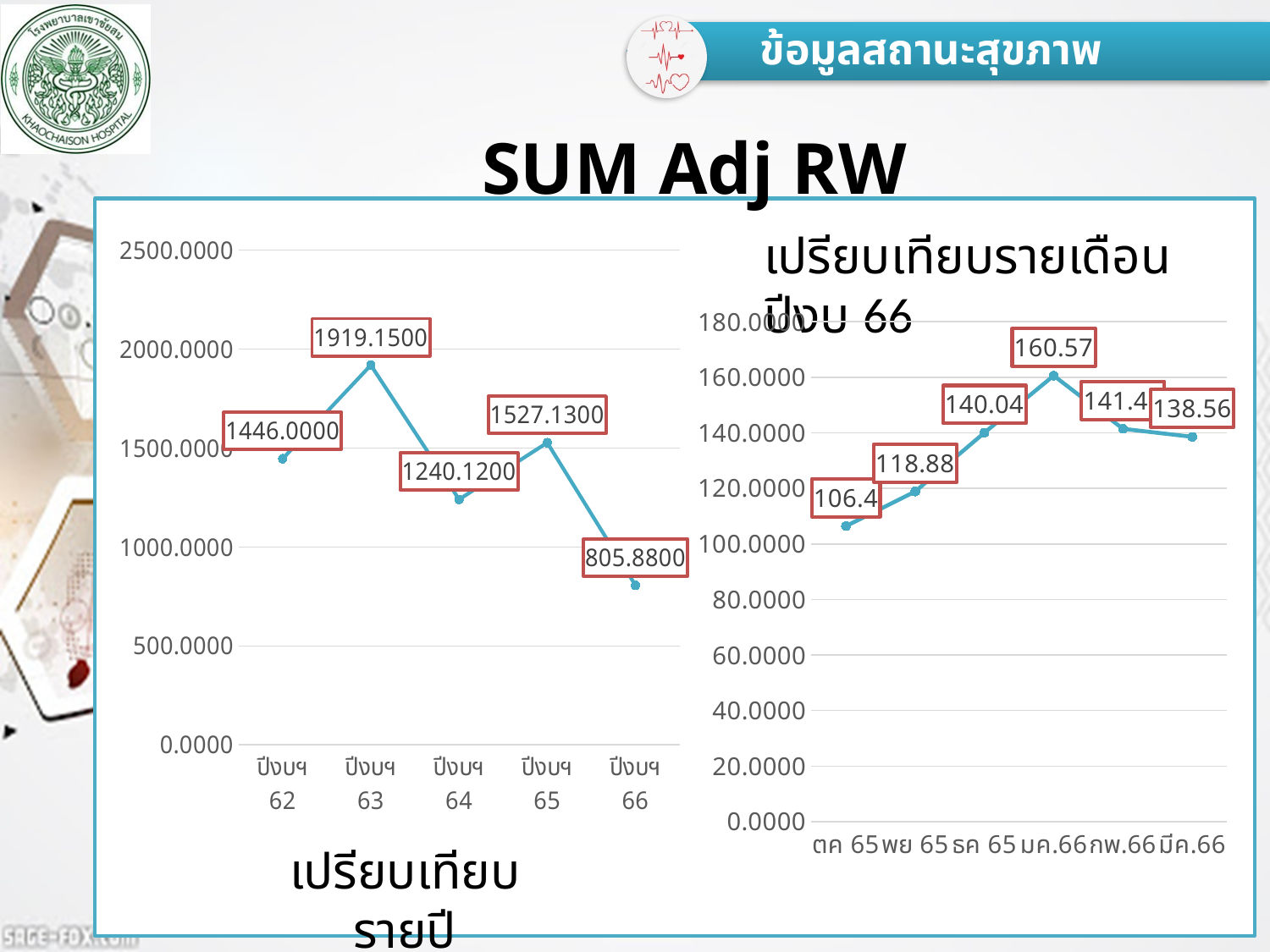
In the left chart (เปรียบเทียบรายปี), which year has the highest value? ปีงบฯ 63 In the left chart (เปรียบเทียบรายปี), which year has the lowest value? ปีงบฯ 66 In the right chart (เปรียบเทียบรายเดือน ปีงบ 66), which month has the highest value? มค.66 In the right chart (เปรียบเทียบรายเดือน ปีงบ 66), how many months are plotted? 6 In the left chart (เปรียบเทียบรายปี), what is the value for ปีงบฯ 63? 1919.1500 In the right chart (เปรียบเทียบรายเดือน ปีงบ 66), what is the value for มค.66? 160.57 In the right chart (เปรียบเทียบรายเดือน ปีงบ 66), what is the value for ธค 65? 140.04 In the left chart (เปรียบเทียบรายปี), what is the difference between the values for ปีงบฯ 65 and ปีงบฯ 64? 287.0100 In the right chart (เปรียบเทียบรายเดือน ปีงบ 66), is the value for ตค 65 greater or less than 120.0000? less What kind of chart is the left chart (เปรียบเทียบรายปี)? Line chart In the left chart (เปรียบเทียบรายปี), what is the value for ปีงบฯ 66? 805.8800 In the left chart (เปรียบเทียบรายปี), how many years are plotted? 5